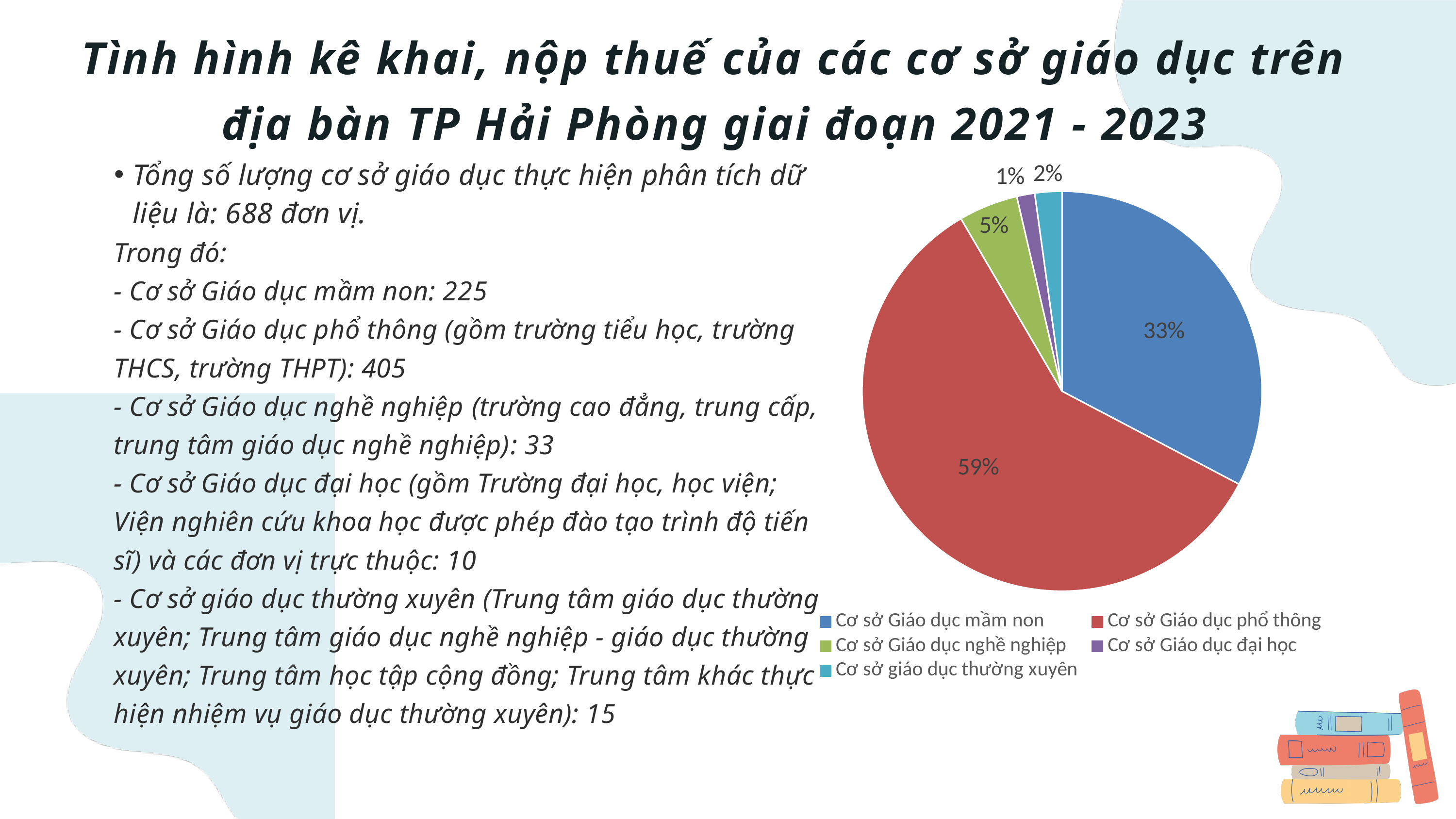
Which category has the smallest slice of the pie? Cơ sở Giáo dục đại học Which is larger, the share of Cơ sở Giáo dục nghề nghiệp or the share of Cơ sở giáo dục thường xuyên? Cơ sở Giáo dục nghề nghiệp What share of the pie does Cơ sở Giáo dục mầm non have? 33% How many categories does the legend of the pie chart list? 5 What is the difference in percentage points between the shares of Cơ sở Giáo dục phổ thông and Cơ sở Giáo dục mầm non? 26 What share of the pie does Cơ sở giáo dục thường xuyên have? 2% What share of the pie does Cơ sở Giáo dục nghề nghiệp have? 5% Which category has the largest slice of the pie? Cơ sở Giáo dục phổ thông What colour is the slice for Cơ sở Giáo dục mầm non? blue What kind of chart is shown on the slide? pie chart